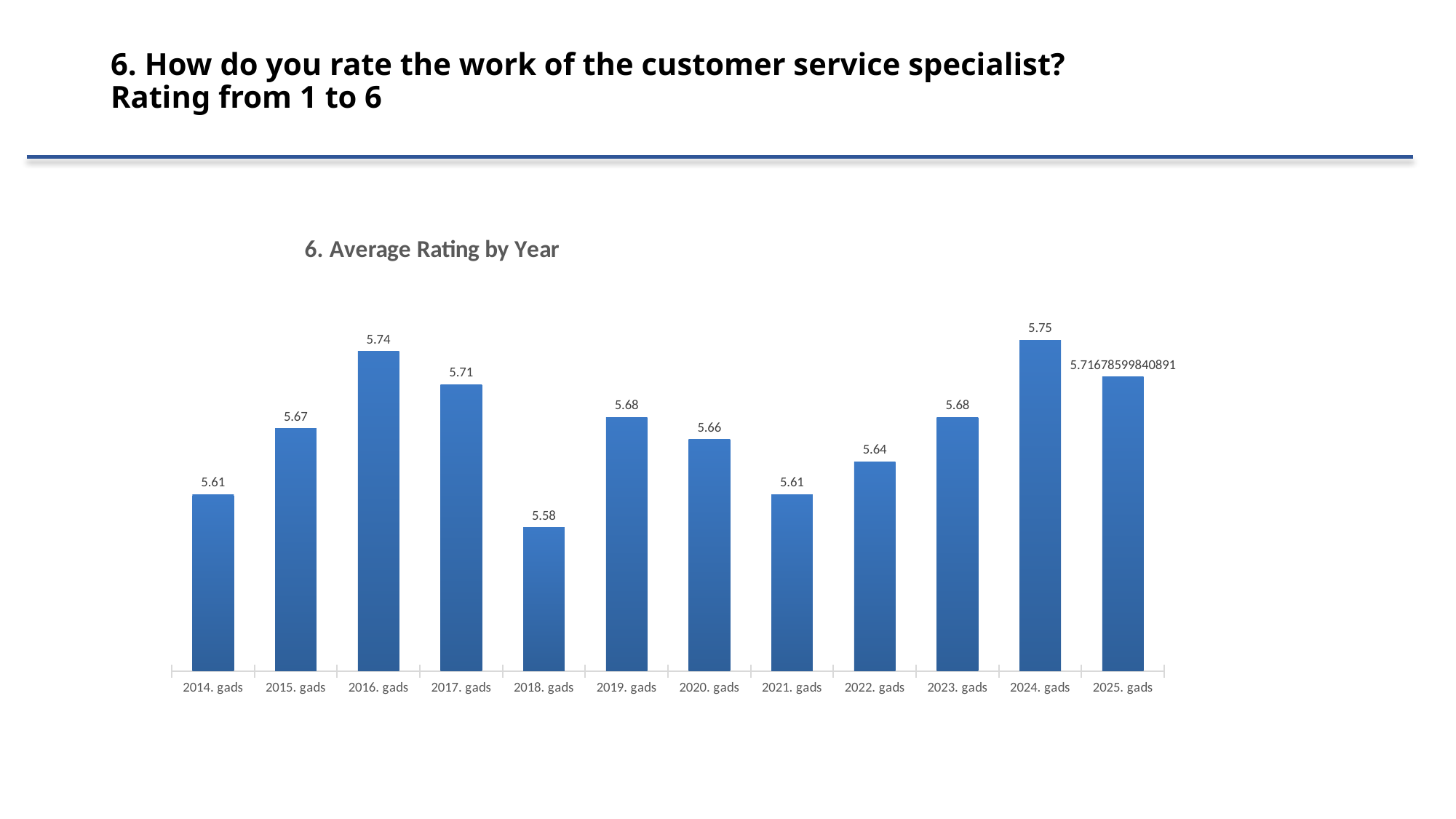
What is the difference between the ratings for 2016. gads and 2015. gads? 0.07 Which has a higher average rating, 2017. gads or 2020. gads? 2017. gads What is the difference between the ratings for 2024. gads and 2018. gads? 0.17 How many years are shown on the chart? 12 What is the average rating for 2016. gads? 5.74 What is the title of the chart? 6. Average Rating by Year What is the average rating for 2018. gads? 5.58 What is the data label shown for 2025. gads? 5.71678599840891 Which year has the lowest average rating? 2018. gads What kind of chart is shown on the slide? Bar chart Which year has the highest average rating? 2024. gads Which has a higher average rating, 2022. gads or 2023. gads? 2023. gads